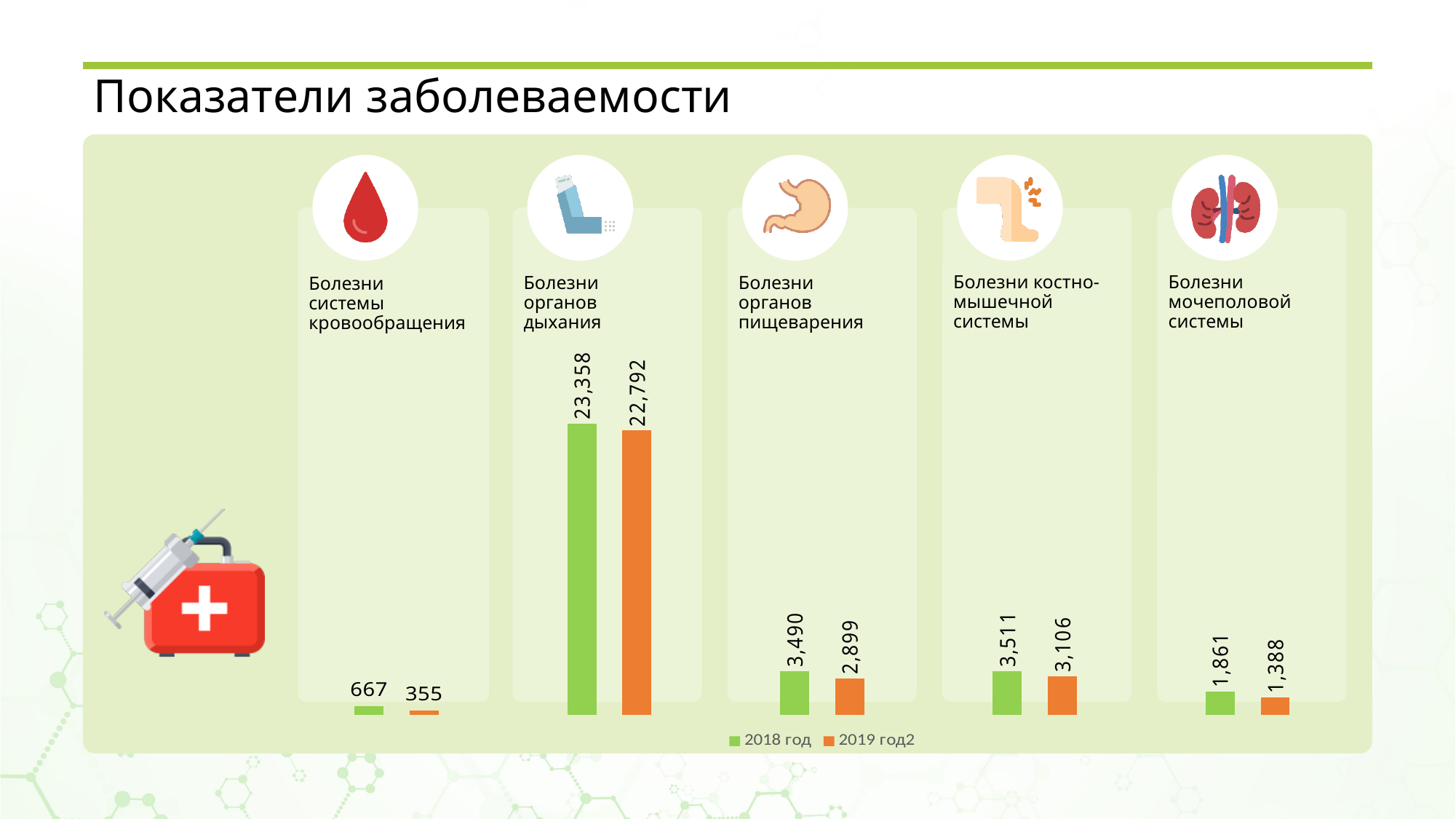
How many disease categories are shown in the chart? 5 What is the 2018 год value for Болезни костно-мышечной системы? 3,511 What is the 2018 год value for Болезни органов дыхания? 23,358 Which is larger: the 2019 год2 value for Болезни костно-мышечной системы or the 2019 год2 value for Болезни органов пищеварения? Болезни костно-мышечной системы Which category has the highest 2018 год value? Болезни органов дыхания What is the difference between the 2018 год and 2019 год2 values for Болезни органов дыхания? 566 What is the 2019 год2 value for Болезни мочеполовой системы? 1,388 Which category has the lowest 2019 год2 value? Болезни системы кровообращения What type of chart is shown on the slide? Bar chart What is the 2019 год2 value for Болезни системы кровообращения? 355 How many series does the legend list? 2 What is the difference between the 2018 год and 2019 год2 values for Болезни органов пищеварения? 591